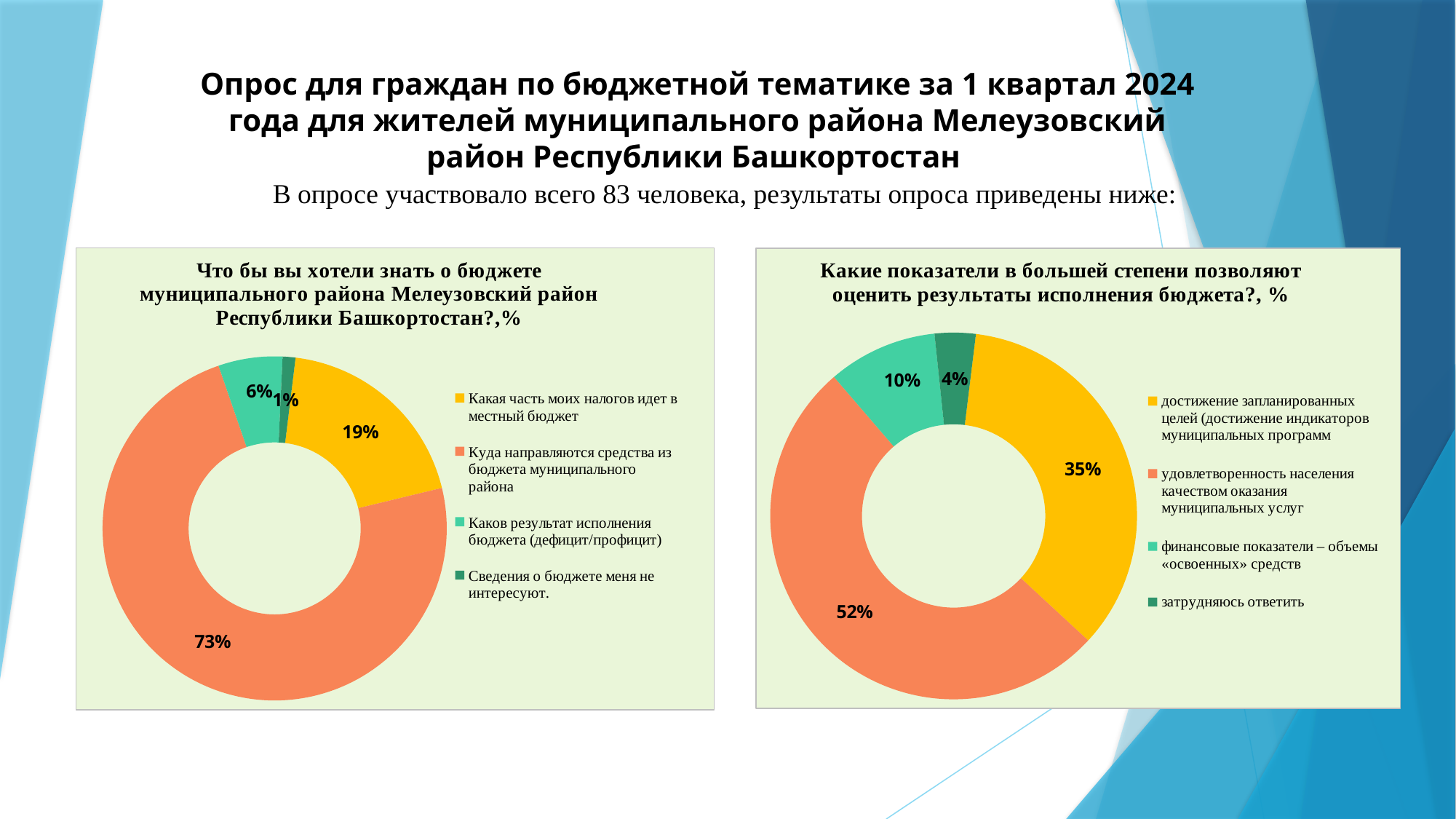
What type of chart is used on the right side of the slide? Doughnut (pie) chart In the left chart, which answer option has the largest share? Куда направляются средства из бюджета муниципального района In the right chart, what is the difference between the shares for "достижение запланированных целей" and "затрудняюсь ответить"? 31% In the right chart, which is larger: the share for "достижение запланированных целей" or the share for "удовлетворенность населения качеством оказания муниципальных услуг"? удовлетворенность населения качеством оказания муниципальных услуг In the left chart, what share of respondents chose "Сведения о бюджете меня не интересуют"? 1% In the left chart, what is the difference between the shares for "Куда направляются средства из бюджета муниципального района" and "Какая часть моих налогов идет в местный бюджет"? 54% In the left chart, what share of respondents chose "Какая часть моих налогов идет в местный бюджет"? 19% In the right chart, which answer option has the smallest share? затрудняюсь ответить In the right chart, what share of respondents chose "финансовые показатели – объемы «освоенных» средств"? 10% How many answer options does the legend of the left chart list? 4 In the left chart, what share of respondents chose "Куда направляются средства из бюджета муниципального района"? 73% In the right chart, what share of respondents chose "удовлетворенность населения качеством оказания муниципальных услуг"? 52%